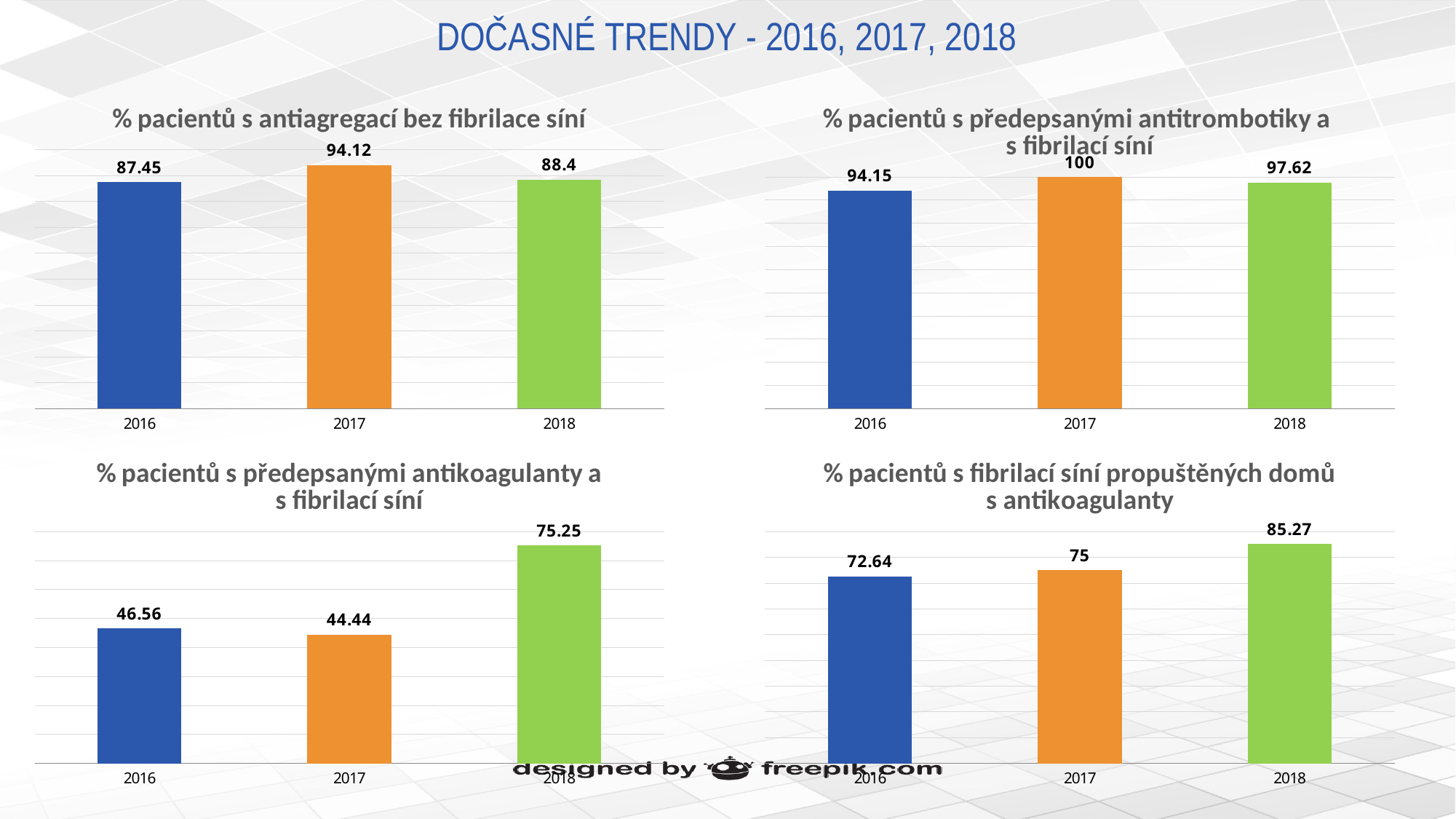
In the chart '% pacientů s fibrilací síní propuštěných domů s antikoagulanty', what is the difference between the 2018 and 2016 values? 12.63 In the chart '% pacientů s fibrilací síní propuštěných domů s antikoagulanty', do the values rise or fall from 2016 to 2018? rise In the chart '% pacientů s antiagregací bez fibrilace síní', which year has the lowest value? 2016 How many bars are shown in the chart '% pacientů s předepsanými antikoagulanty a s fibrilací síní'? 3 In the chart '% pacientů s předepsanými antikoagulanty a s fibrilací síní', what is the difference between the 2018 and 2017 values? 30.81 In the chart '% pacientů s antiagregací bez fibrilace síní', what is the value for 2017? 94.12 In the chart '% pacientů s předepsanými antikoagulanty a s fibrilací síní', what is the value for 2016? 46.56 In the chart '% pacientů s fibrilací síní propuštěných domů s antikoagulanty', what is the value for 2017? 75 In the chart '% pacientů s předepsanými antitrombotiky a s fibrilací síní', which year has the highest value? 2017 In the chart '% pacientů s antiagregací bez fibrilace síní', which is larger, the value for 2016 or 2018? 2018 What type of chart is '% pacientů s předepsanými antitrombotiky a s fibrilací síní'? bar chart In the chart '% pacientů s předepsanými antitrombotiky a s fibrilací síní', what is the value for 2018? 97.62